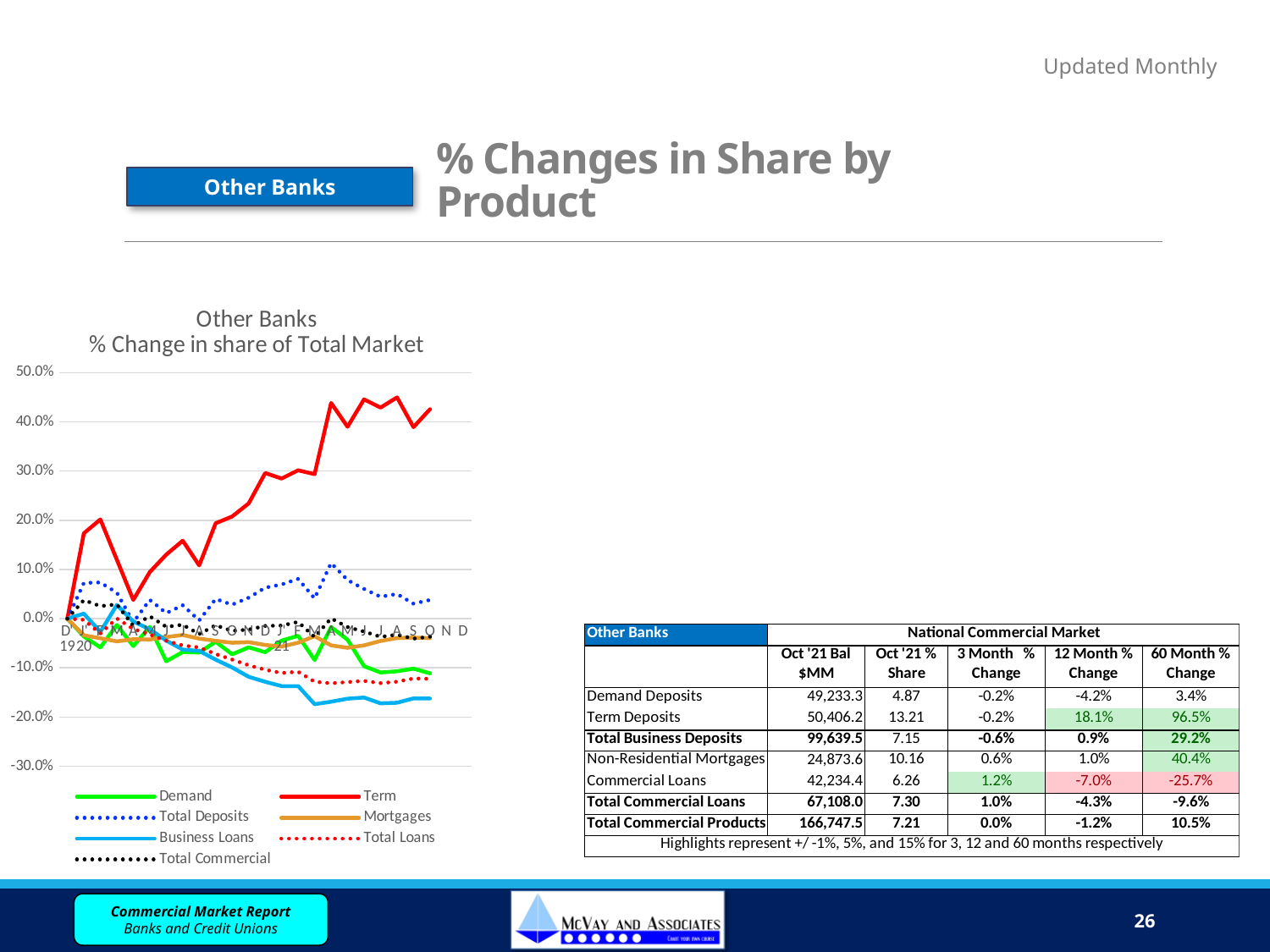
What is the title of the chart? Other Banks % Change in share of Total Market Does the Term series generally rise or fall from left to right across the chart? rise Which series reaches the lowest value on the chart? Business Loans Is the final value of the Business Loans series greater or less than -10.0%? less At the end of the chart, which series is higher: Term or Total Deposits? Term Does the Business Loans series generally rise or fall from left to right across the chart? fall Which series reaches the highest value on the chart? Term What is the highest value shown on the chart's vertical axis? 50.0% How many series does the chart legend list? 7 What kind of chart is shown on the slide? line chart Is the peak value of the Term series greater or less than 40.0%? greater Is the peak value of the Total Deposits series greater or less than 20.0%? less